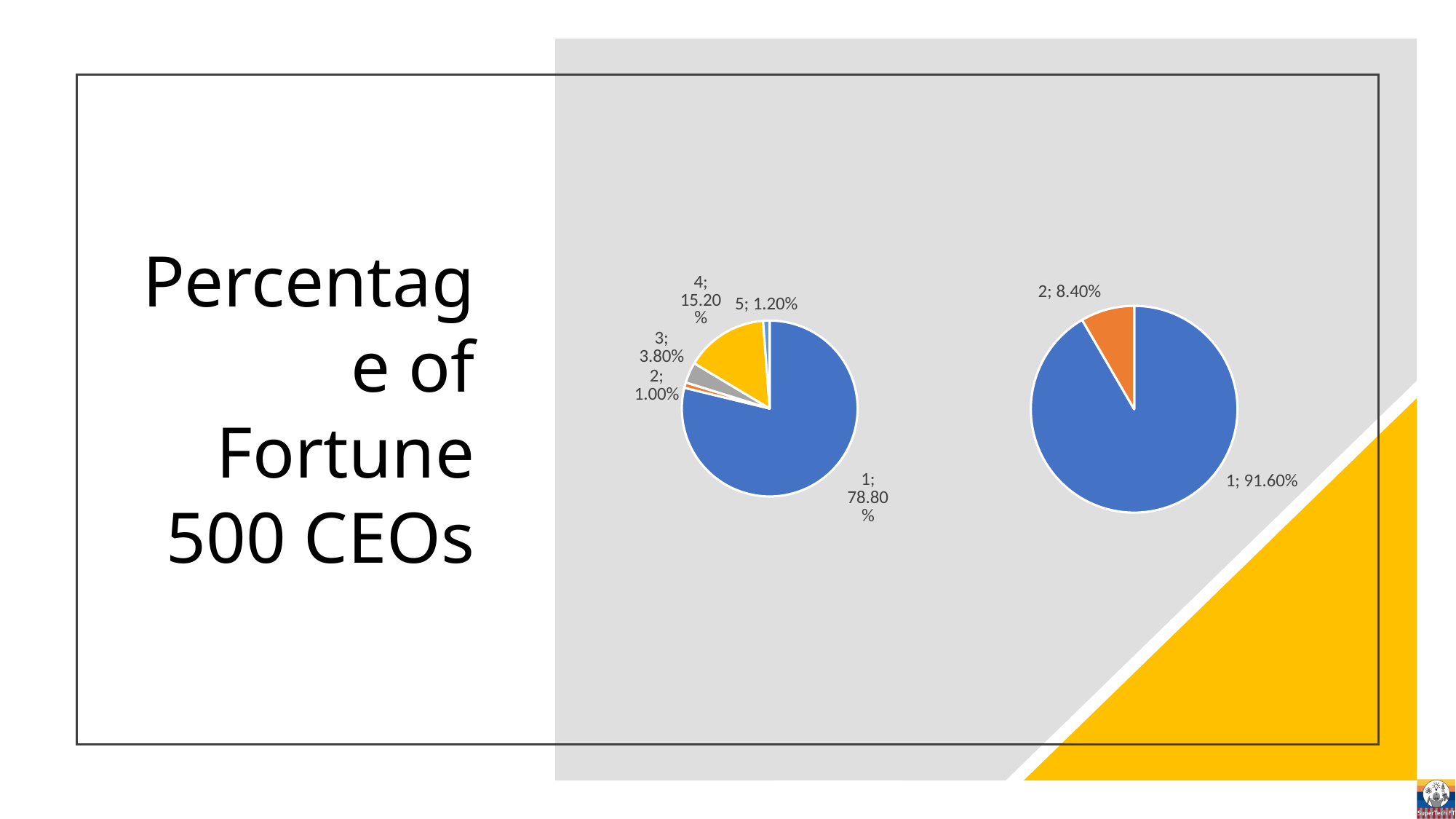
In the left pie chart, what is the value for category 4? 15.20% In the left pie chart, what is the value for category 1? 78.80% In the left pie chart, which category has the smallest slice? 2 In the left pie chart, how many slices are there? 5 In the left pie chart, which category has the largest slice? 1 What type of chart is shown on the right side of the slide? Pie chart In the right pie chart, what is the value for category 1? 91.60% In the left pie chart, what is the value for category 5? 1.20% In the left pie chart, what is the value for category 3? 3.80% In the right pie chart, what is the value for category 2? 8.40% In the right pie chart, how many slices are there? 2 In the left pie chart, what is the difference between the values for category 4 and category 3? 11.40%